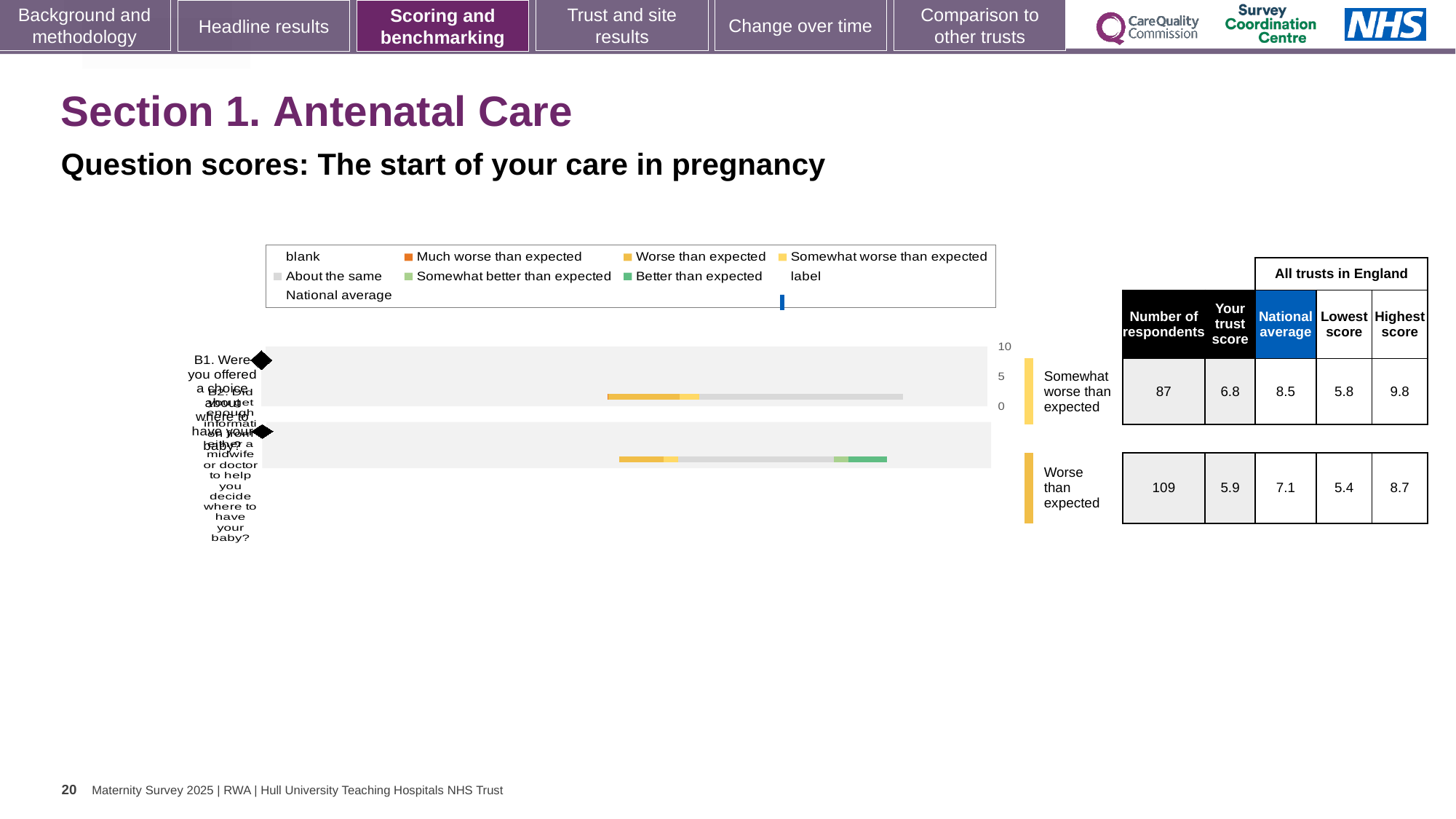
Which question is rated 'Worse than expected' in the chart? B2 What is the highest score for question B2 in the table beside the chart? 8.7 Which question has the lowest 'Lowest score' value in the table? B2 Which question has the higher trust score, B1 or B2? B1 What kind of chart is shown on the slide? Bar chart What is the difference between the highest and lowest scores for question B2? 3.3 What is the number of respondents for question B1 in the table beside the chart? 87 Which question is rated 'Somewhat worse than expected' in the chart? B1 What is the national average for question B1 in the table beside the chart? 8.5 What is the trust score for question B2 in the table beside the chart? 5.9 What is the difference between the national average and the trust score for question B1? 1.7 How many questions (bars) are plotted in the chart? 2